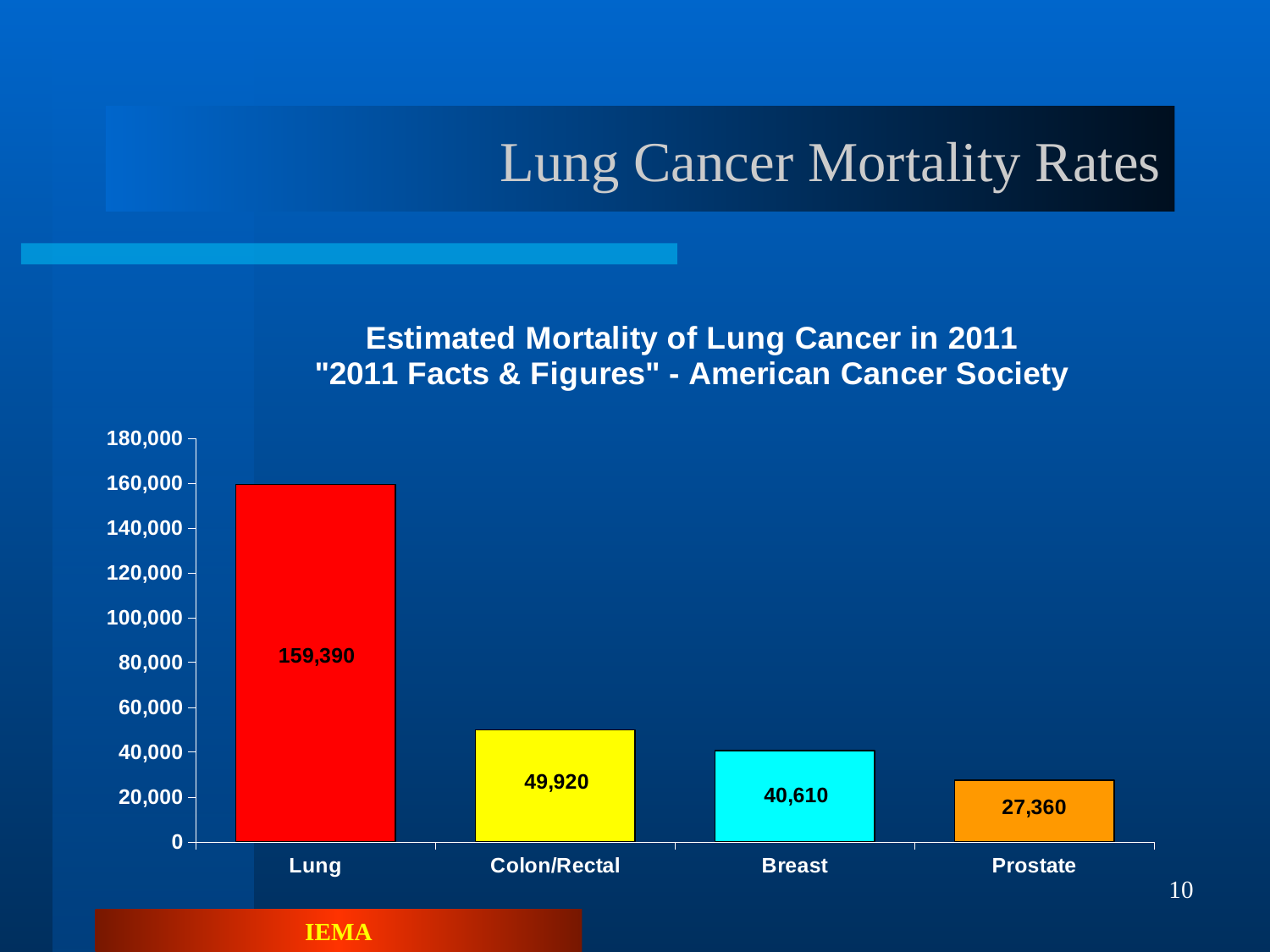
What is the title of the chart? Estimated Mortality of Lung Cancer in 2011 "2011 Facts & Figures" - American Cancer Society What is the difference between the Lung and Colon/Rectal values? 109,470 What is the estimated mortality value for Lung? 159,390 What is the estimated mortality value for Colon/Rectal? 49,920 What is the difference between the Breast and Prostate values? 13,250 What is the estimated mortality value for Breast? 40,610 What kind of chart is shown on the slide? Bar chart Which is larger, the value for Colon/Rectal or the value for Breast? Colon/Rectal What is the estimated mortality value for Prostate? 27,360 How many categories are shown on the chart? 4 Which category has the lowest estimated mortality? Prostate Which category has the highest estimated mortality? Lung